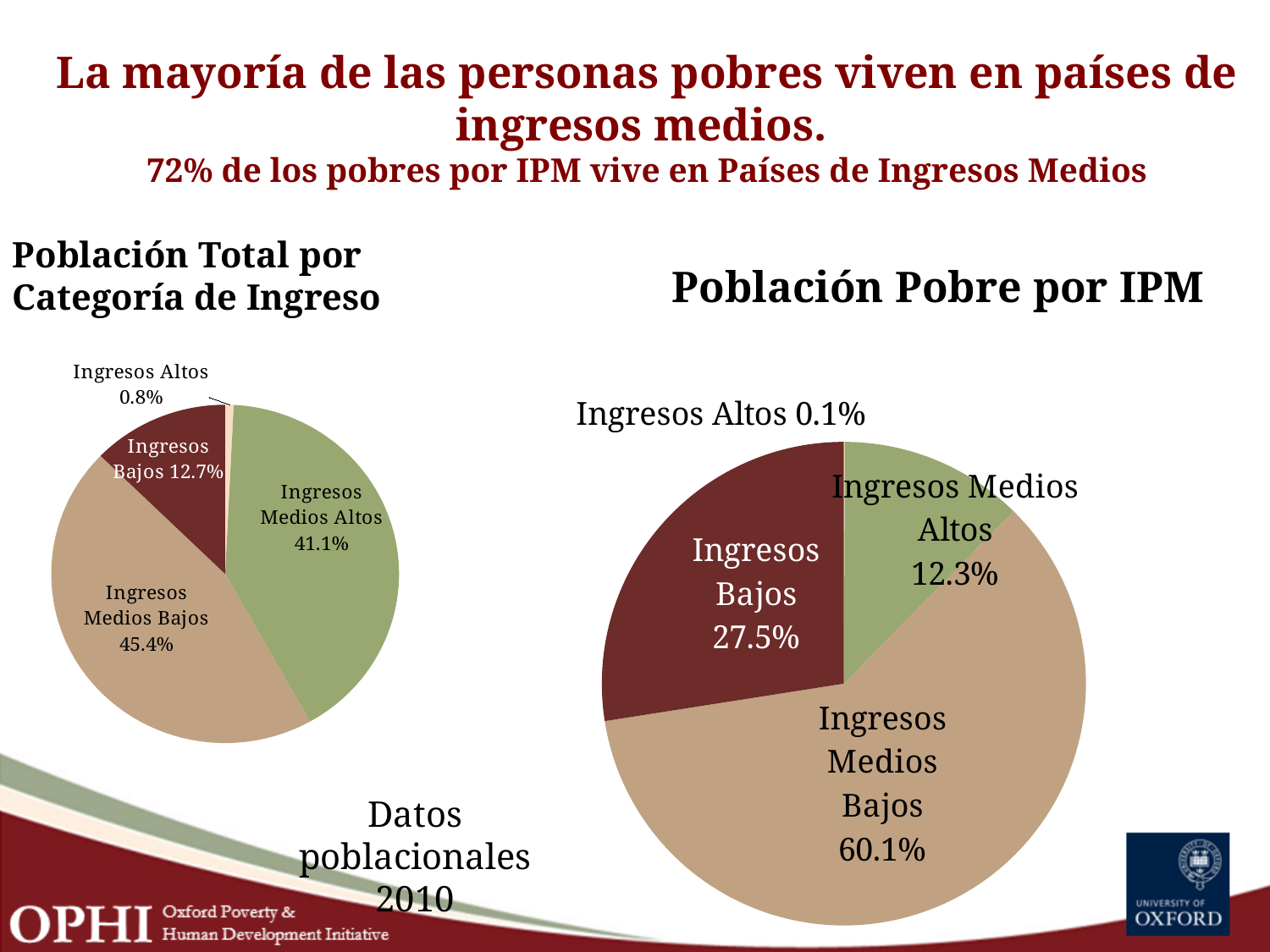
In the 'Población Pobre por IPM' chart, what is the difference between the Ingresos Medios Bajos share and the Ingresos Bajos share? 32.6% In the 'Población Total por Categoría de Ingreso' chart, which category has the smallest slice? Ingresos Altos In the 'Población Total por Categoría de Ingreso' chart, what is the share for Ingresos Medios Bajos? 45.4% In the 'Población Pobre por IPM' chart, which category has the largest slice? Ingresos Medios Bajos In the 'Población Total por Categoría de Ingreso' chart, which is larger: Ingresos Medios Altos or Ingresos Bajos? Ingresos Medios Altos In the 'Población Pobre por IPM' chart, what is the combined share of Ingresos Medios Altos and Ingresos Medios Bajos? 72.4% In the 'Población Pobre por IPM' chart, what is the share for Ingresos Medios Altos? 12.3% What colour is the Ingresos Bajos slice in the 'Población Pobre por IPM' chart? dark red What kind of chart is the 'Población Pobre por IPM' chart? pie chart In the 'Población Pobre por IPM' chart, what is the share for Ingresos Bajos? 27.5% In the 'Población Total por Categoría de Ingreso' chart, what is the share for Ingresos Altos? 0.8% How many slices does the 'Población Pobre por IPM' pie chart have? 4